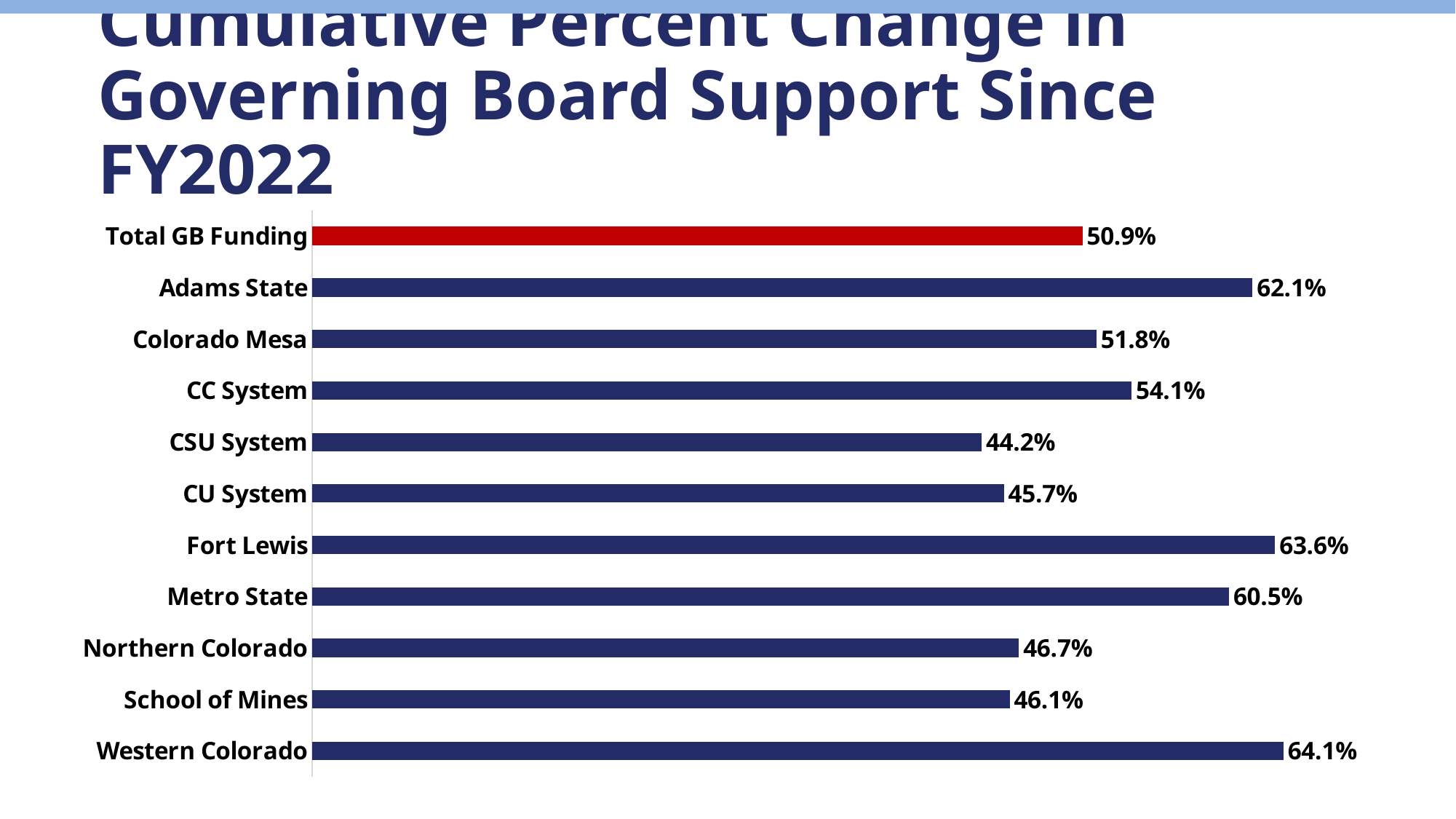
What is the cumulative percent change for CSU System? 44.2% What is the value shown for Total GB Funding? 50.9% Which is larger, the value for CC System or the value for Colorado Mesa? CC System Which category has the lowest cumulative percent change? CSU System Which bar is shown in red rather than dark blue? Total GB Funding What is the cumulative percent change for Adams State? 62.1% What kind of chart is shown on the slide? Bar chart How many bars are shown in the chart? 11 Which is larger, the value for Northern Colorado or the value for School of Mines? Northern Colorado What is the difference between the values for Western Colorado and Total GB Funding? 13.2% Which category has the highest cumulative percent change? Western Colorado What is the difference between the values for Fort Lewis and Metro State? 3.1%